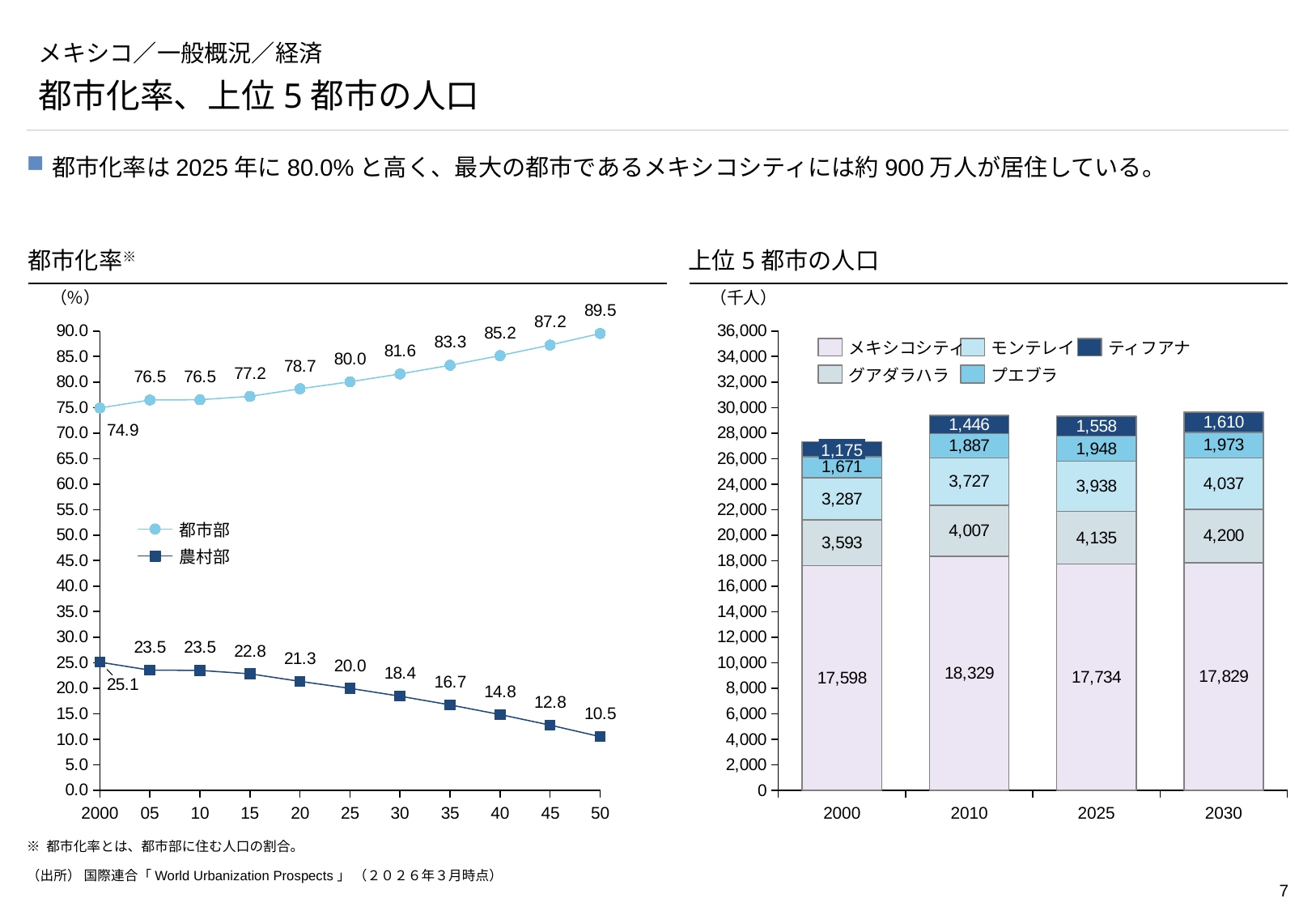
In the 上位5都市の人口 chart, what is the total of the stacked bar for 2000? 27,324 In the 都市化率 chart, how many series does the legend list? 2 In the 上位5都市の人口 chart, which year has the highest value for グアダラハラ? 2030 In the 上位5都市の人口 chart, how many series does the legend list? 5 In the 都市化率 chart, what is the value for 農村部 in 2050? 10.5 In the 都市化率 chart, what is the difference between the 都市部 and 農村部 values in 2000? 49.8 In the 都市化率 chart, what is the value for 都市部 in 2025? 80.0 In the 都市化率 chart, how many data points are plotted for the 都市部 series? 11 In the 都市化率 chart, does the 農村部 series rise or fall from 2000 to 2050? fall What kind of chart is the 上位5都市の人口 chart? stacked bar chart In the 上位5都市の人口 chart, what is the value for ティフアナ in 2030? 1,610 In the 上位5都市の人口 chart, what is the value for メキシコシティ in 2010? 18,329